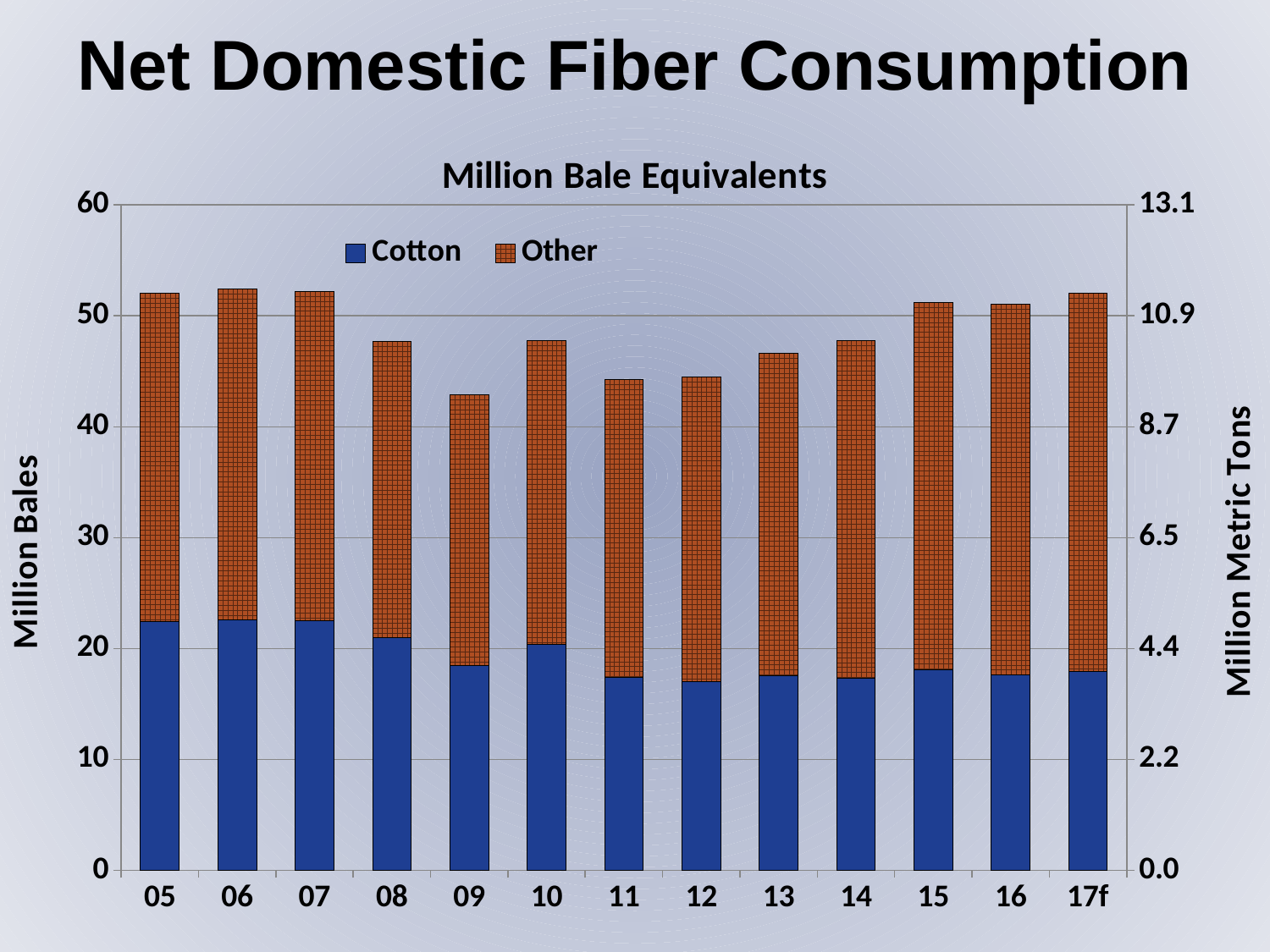
What is the label of the left vertical axis? Million Bales Is the Cotton value for 12 greater or less than 20 million bales? less Does total fiber consumption rise or fall from 07 to 09? Fall How many years (categories) are shown on the x axis? 13 How many series does the legend list? 2 Is the total bar for 09 greater or less than 50 million bales? less Which year has the lowest total fiber consumption? 09 Is the Cotton value for 05 greater or less than 20 million bales? greater Which year has the larger total bar, 09 or 10? 10 What is the label of the right vertical axis? Million Metric Tons What kind of chart is shown on the slide? Stacked bar chart